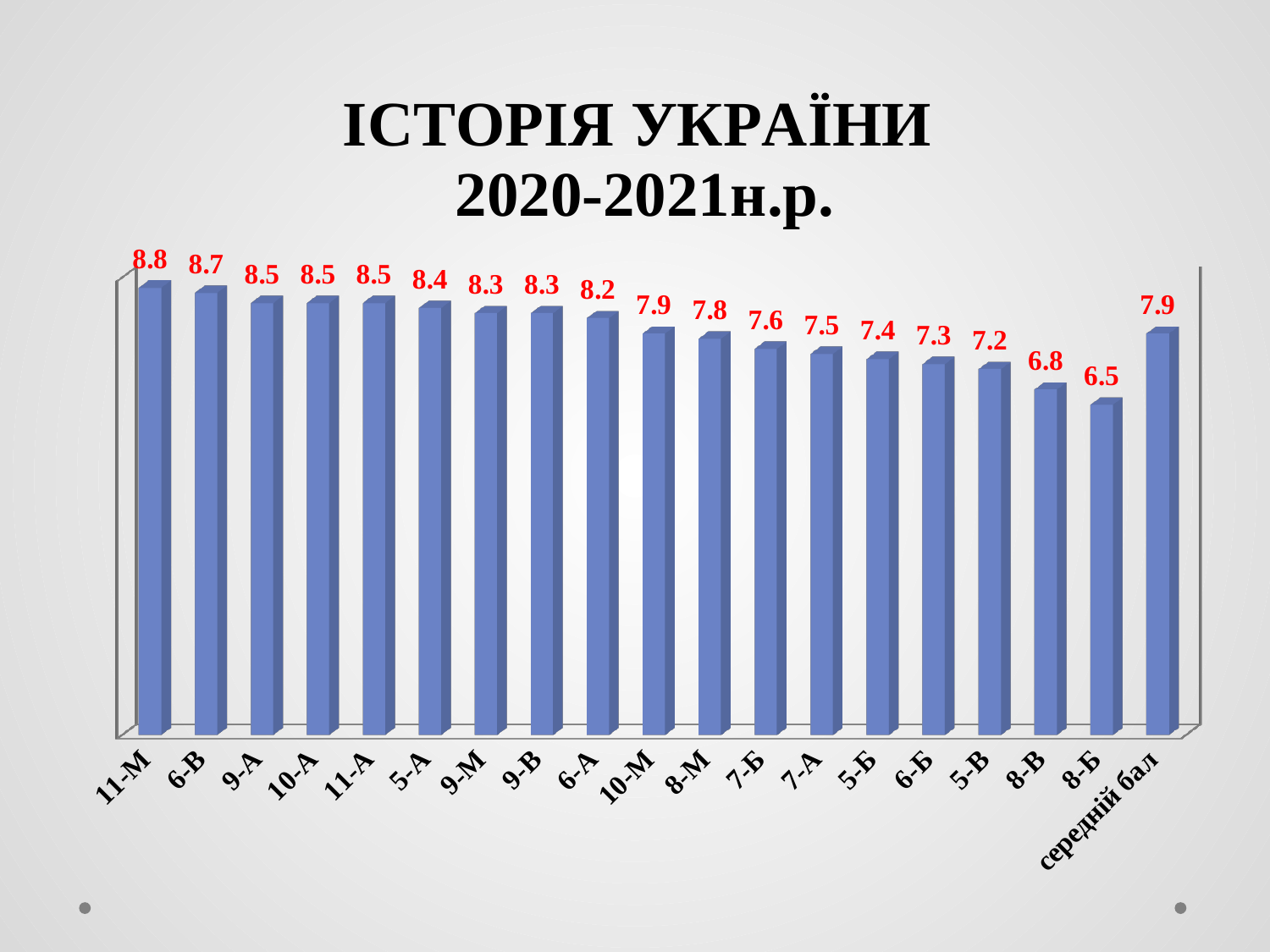
What is the difference between the values for 6-А and 7-Б? 0.6 Do the values for the classes rise or fall from left to right, before the 'середній бал' bar? fall What kind of chart is shown on the slide? bar chart What value is shown for class 8-В? 6.8 Which class has the lowest value on the chart? 8-Б What is the difference between the values for 11-М and 8-Б? 2.3 How many bars are plotted on the chart? 19 What is the value of the bar labelled 'середній бал'? 7.9 Which has a higher value, 5-А or 5-Б? 5-А Which class has the highest value on the chart? 11-М What value is shown for class 6-В? 8.7 Which has a higher value, 8-М or 8-В? 8-М